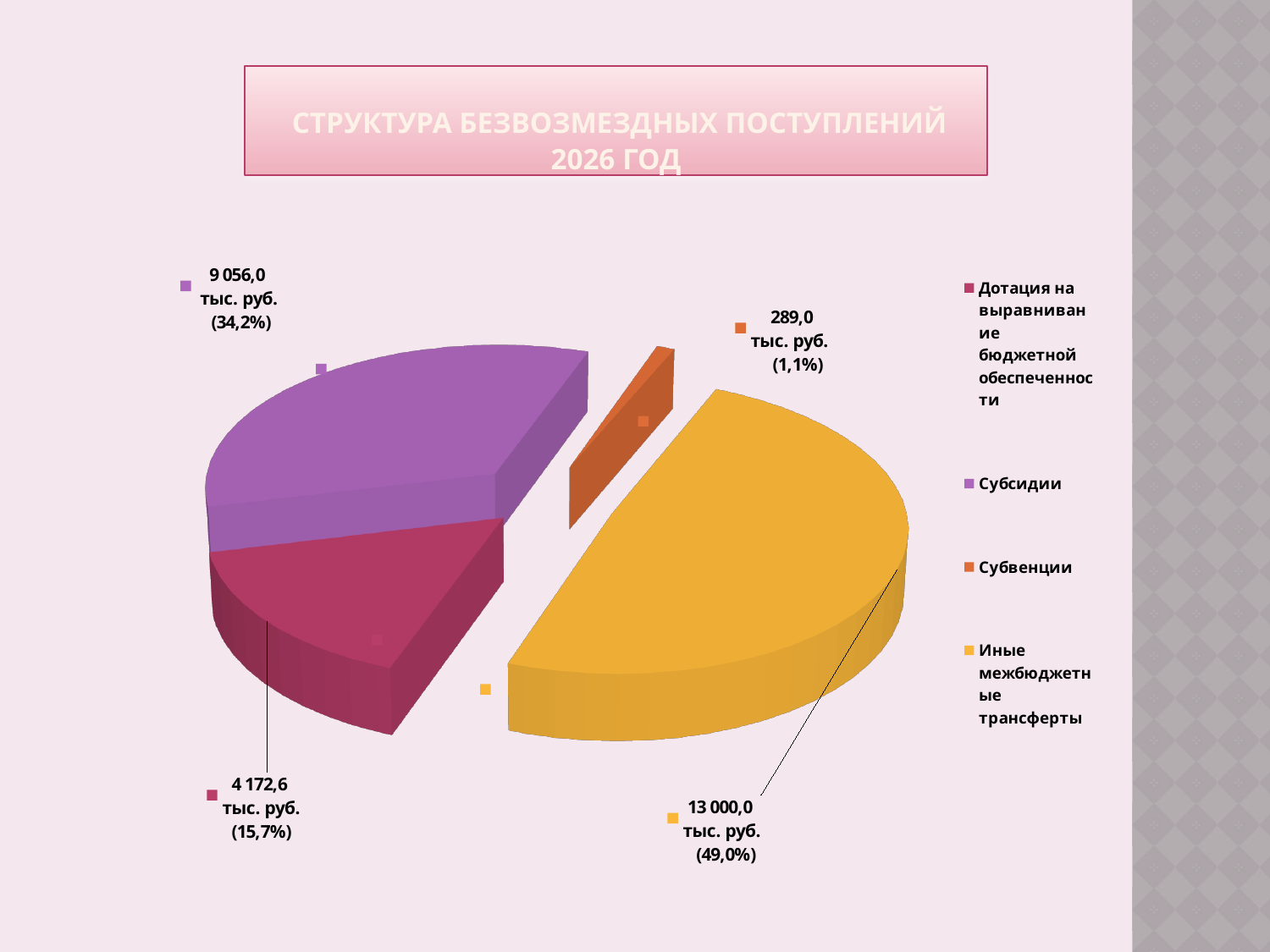
Which is larger, Субсидии or Дотация на выравнивание бюджетной обеспеченности? Субсидии What is the title of the chart on the slide? СТРУКТУРА БЕЗВОЗМЕЗДНЫХ ПОСТУПЛЕНИЙ 2026 ГОД What is the value for Дотация на выравнивание бюджетной обеспеченности? 4 172,6 тыс. руб. What share of the pie does Субсидии represent? 34,2% Which category has the smallest slice of the pie? Субвенции What is the value for Иные межбюджетные трансферты? 13 000,0 тыс. руб. How many categories does the pie chart have? 4 What share of the pie does Дотация на выравнивание бюджетной обеспеченности represent? 15,7% What is the value for Субсидии? 9 056,0 тыс. руб. What is the value for Субвенции? 289,0 тыс. руб. What kind of chart is shown on the slide? Pie chart Which category has the largest slice of the pie? Иные межбюджетные трансферты